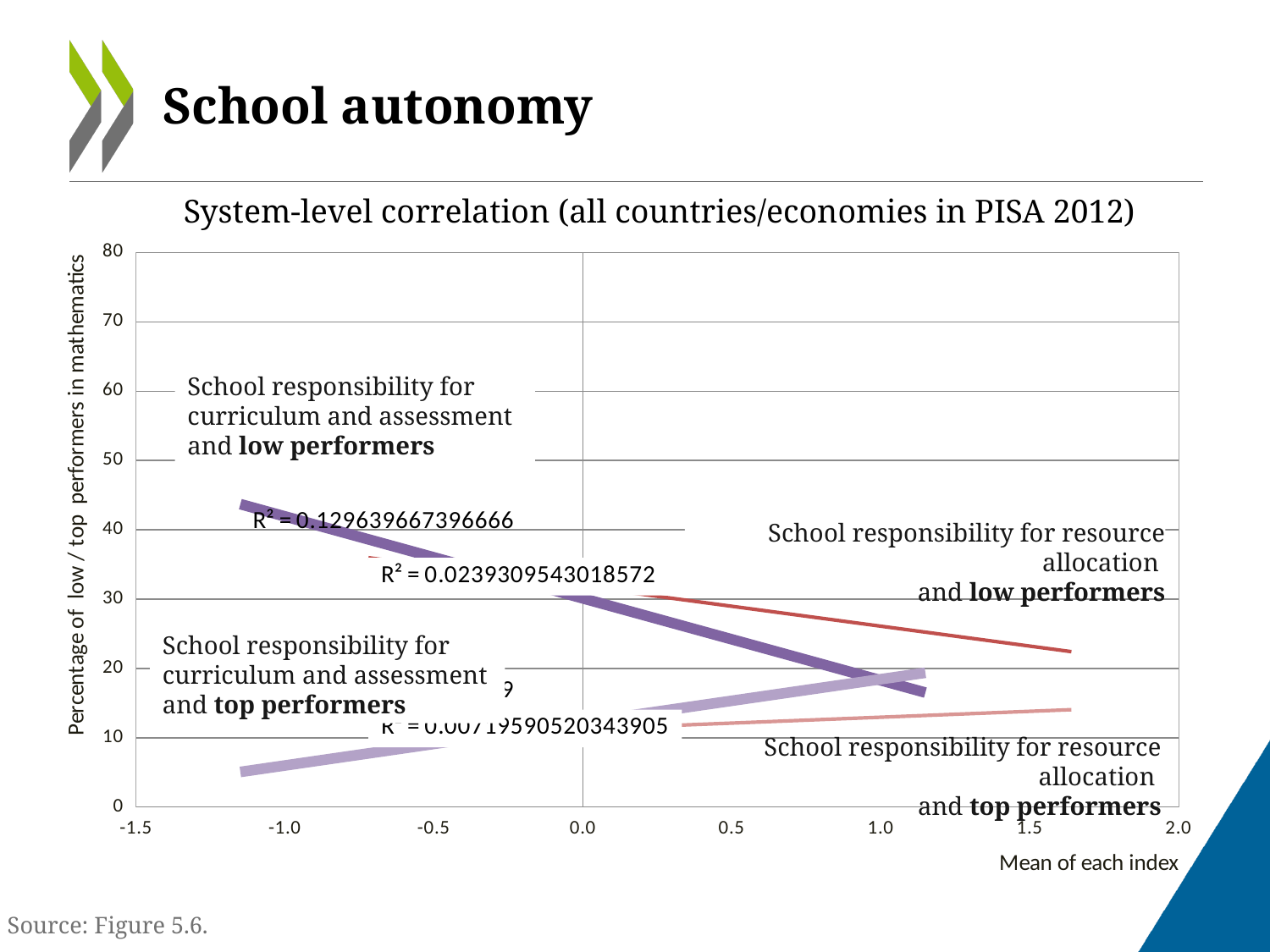
What R² value is printed for the line for school responsibility for resource allocation and low performers? 0.0239309543018572 At a mean index of -1.0, is the value of the line for school responsibility for curriculum and assessment and top performers greater or less than 10? less How many trend lines are plotted on the chart? 4 Does the line for school responsibility for curriculum and assessment and top performers rise or fall as the mean of the index increases? rise What is the title of the chart? System-level correlation (all countries/economies in PISA 2012) Does the line for school responsibility for curriculum and assessment and low performers rise or fall as the mean of the index increases? fall What kind of chart is shown on the slide? line chart What R² value is printed for the line for school responsibility for curriculum and assessment and low performers? 0.129639667396666 What is the label of the x axis? Mean of each index Does the line for school responsibility for resource allocation and low performers rise or fall as the mean of the index increases? fall At a mean index of 1.0, which line is higher: school responsibility for resource allocation and low performers, or school responsibility for resource allocation and top performers? school responsibility for resource allocation and low performers At a mean index of -1.0, is the value of the line for school responsibility for curriculum and assessment and low performers greater or less than 30? greater